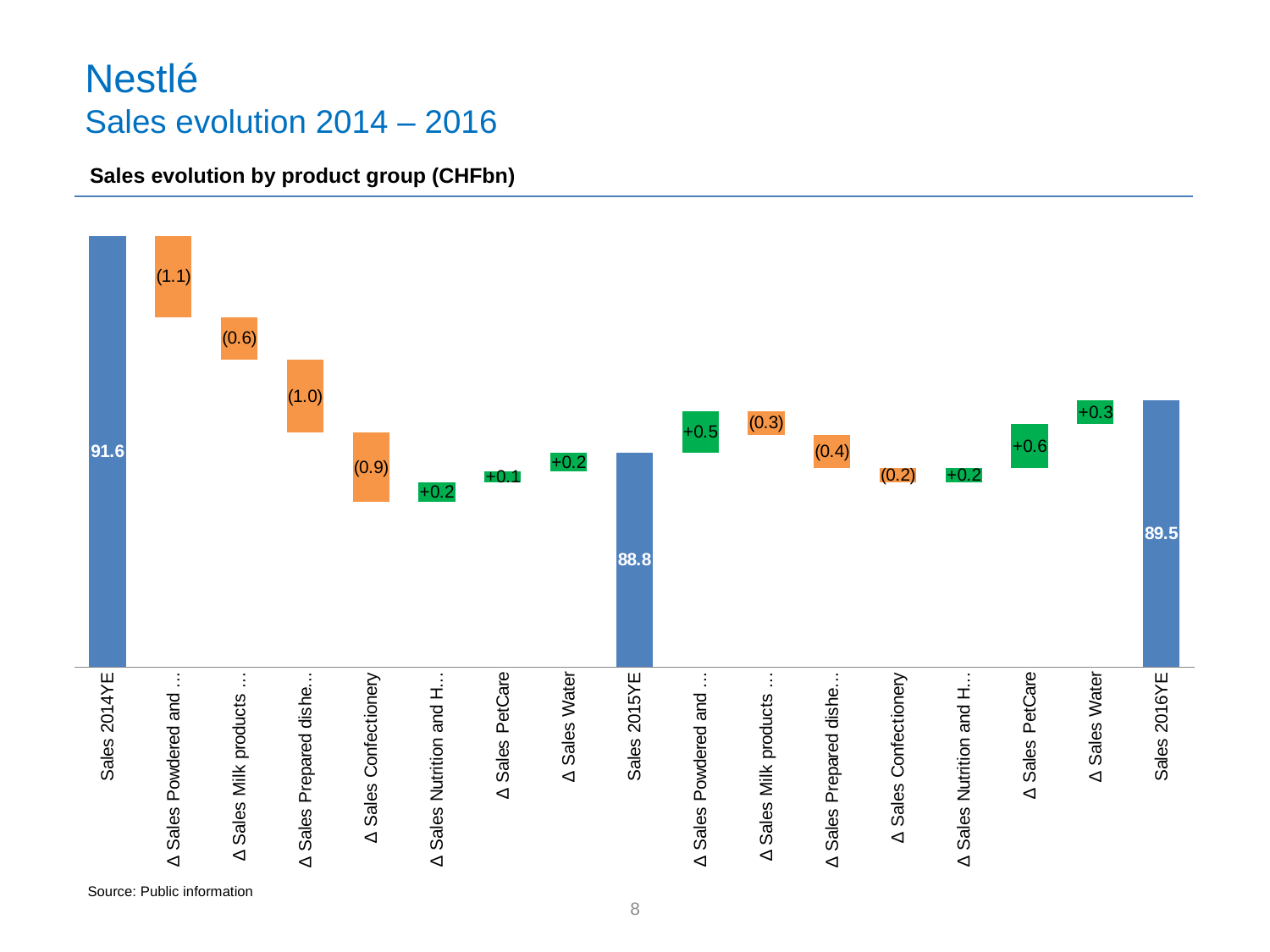
What is the value of the Sales 2014YE bar? 91.6 Which of the three year-end sales bars (2014YE, 2015YE, 2016YE) is the lowest? Sales 2015YE How many bars are plotted on the chart? 17 What is the title of the chart? Sales evolution by product group (CHFbn) What is the value of the Sales 2015YE bar? 88.8 By how much is Sales 2014YE higher than Sales 2015YE? 2.8 Which is larger, Sales 2014YE or Sales 2016YE? Sales 2014YE What is the value shown for Δ Sales Confectionery between Sales 2014YE and Sales 2015YE? (0.9) What is the value shown for Δ Sales Water between Sales 2014YE and Sales 2015YE? +0.2 What is the value shown for Δ Sales PetCare between Sales 2015YE and Sales 2016YE? +0.6 By how much is Sales 2016YE higher than Sales 2015YE? 0.7 What is the value of the Sales 2016YE bar? 89.5